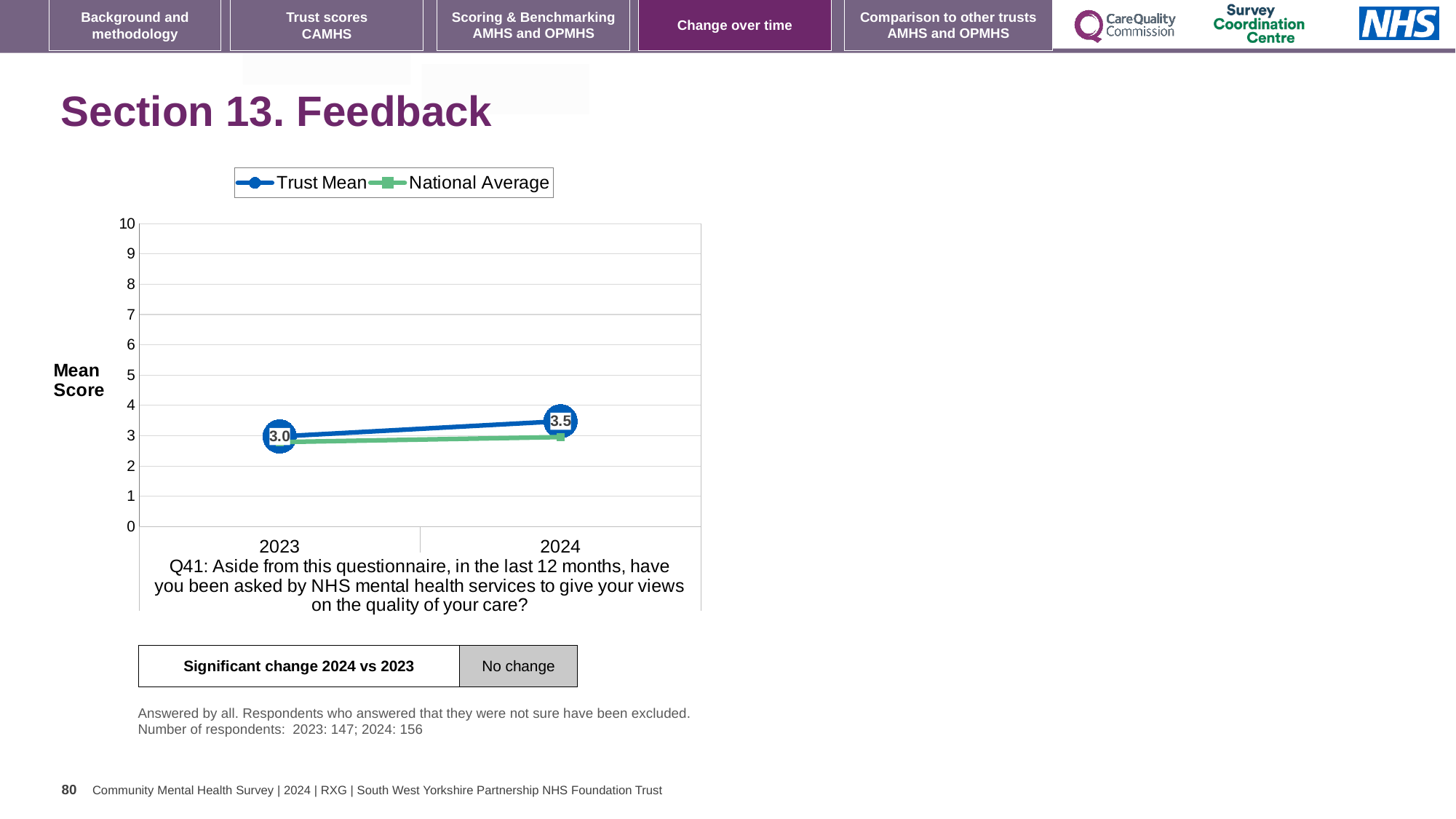
How many years are shown on the x axis? 2 Which year has the higher Trust Mean, 2023 or 2024? 2024 What is the label on the y axis of the chart? Mean Score Is the National Average value for 2023 greater or less than 2? greater Is the National Average value for 2024 greater or less than 4? less What kind of chart is shown on the slide? line chart What is the Trust Mean value for 2023? 3.0 How many series does the legend list? 2 What is the Trust Mean value for 2024? 3.5 Does the Trust Mean rise or fall from 2023 to 2024? rise By how much did the Trust Mean change from 2023 to 2024? 0.5 In 2024, which series is higher, Trust Mean or National Average? Trust Mean